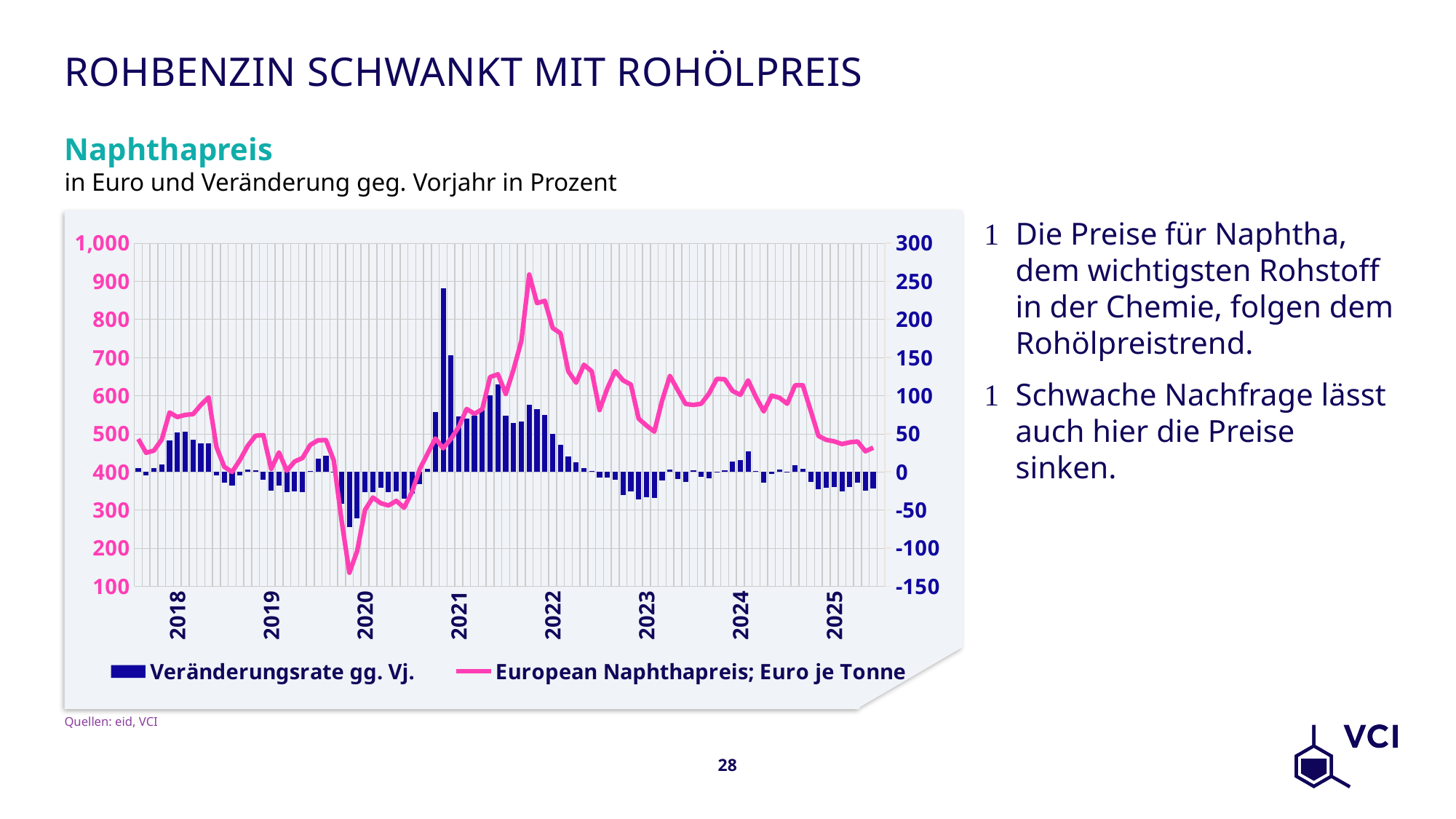
Is the tallest bar of the Veränderungsrate gg. Vj. series greater or less than 200? greater What are the two series named in the chart legend? Veränderungsrate gg. Vj. and European Naphthapreis; Euro je Tonne Is the highest value of the European Naphthapreis line greater or less than 800? greater Which year on the x axis is the first one shown? 2018 How many series does the chart legend list? 2 Are the Veränderungsrate gg. Vj. bars in 2025 greater or less than 0? less What is the title of the chart? Naphthapreis What is the highest value shown on the left axis of the chart? 1,000 Does the European Naphthapreis line rise or fall between 2022 and 2025? fall Does the European Naphthapreis line rise or fall between early 2020 and 2021? rise What kind of chart is shown on the slide? A combined bar and line chart